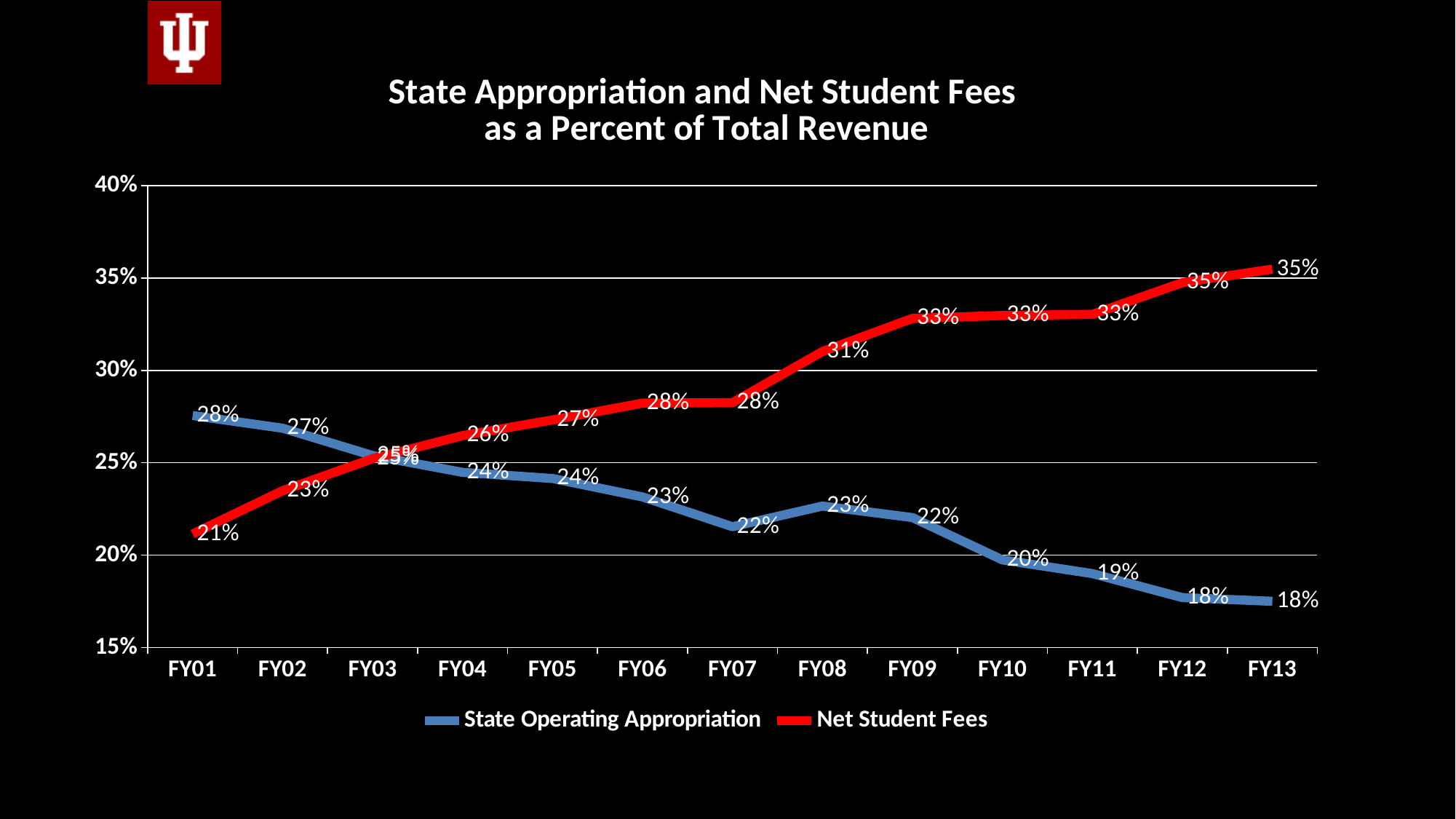
What is the Net Student Fees value for FY13? 35% What is the State Operating Appropriation value for FY01? 28% In FY01, which series is larger: State Operating Appropriation or Net Student Fees? State Operating Appropriation How many series does the legend list? 2 Is the Net Student Fees value for FY09 greater or less than 30%? greater What is the State Operating Appropriation value for FY10? 20% In FY13, what is the difference between Net Student Fees and State Operating Appropriation? 17 percentage points How many fiscal years are shown on the x axis? 13 In which fiscal year is Net Student Fees lowest? FY01 What is the Net Student Fees value for FY08? 31% What kind of chart is shown on the slide? line chart In which fiscal year is the State Operating Appropriation highest? FY01